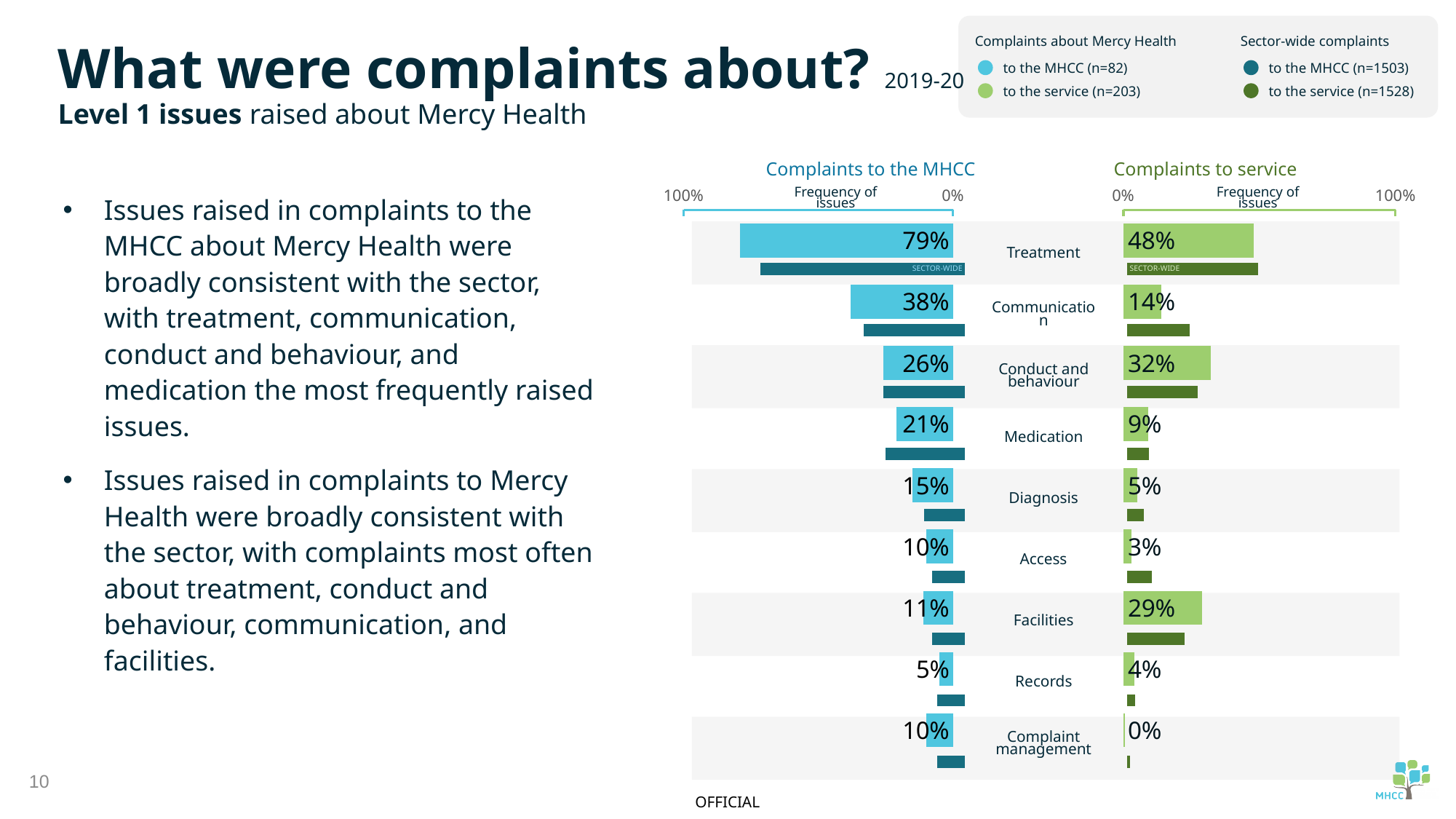
In the 'Complaints to service' chart, which issue has the lowest frequency for Mercy Health? Complaint management In the 'Complaints to the MHCC' chart, what is the difference between the Mercy Health values for Treatment and Communication? 41% In the 'Complaints to the MHCC' chart, is the Mercy Health value for Medication greater or less than the value for Diagnosis? greater How many issue categories are listed in the chart? 9 In the 'Complaints to the MHCC' chart, what percentage of complaints about Mercy Health raised Treatment as an issue? 79% What kind of chart is shown on the slide? Bar chart In the 'Complaints to the MHCC' chart, which issue has the highest frequency for Mercy Health? Treatment For Mercy Health, is the Conduct and behaviour value larger in the 'Complaints to the MHCC' chart or the 'Complaints to service' chart? Complaints to service How many series does the legend at the top right of the slide list? 4 In the 'Complaints to the MHCC' chart, what is the Mercy Health value for Records? 5% In the 'Complaints to service' chart, what is the difference between the Mercy Health values for Treatment and Conduct and behaviour? 16% In the 'Complaints to service' chart, what percentage of complaints to Mercy Health raised Facilities as an issue? 29%